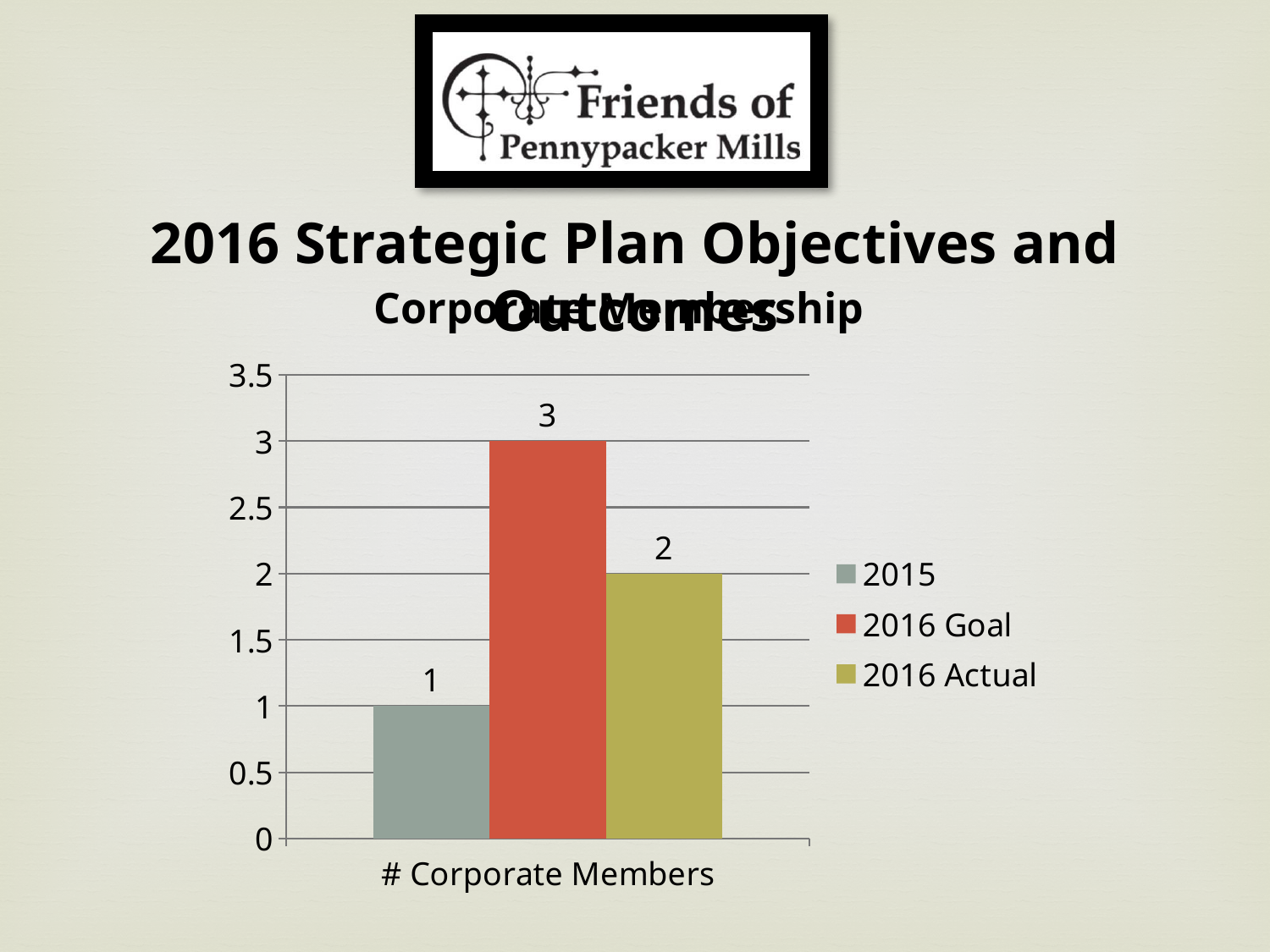
Is the value for 2016 Goal greater or less than 2.5? greater What is the category label shown on the x axis of the chart? # Corporate Members How many series does the legend list? 3 Which series has the lowest value for # Corporate Members? 2015 What kind of chart is shown on the slide? Bar chart What is the value for 2016 Goal in the # Corporate Members chart? 3 Which is larger for # Corporate Members, the 2016 Actual value or the 2015 value? 2016 Actual Which series has the highest value for # Corporate Members? 2016 Goal What is the difference between the 2016 Goal and the 2016 Actual values for # Corporate Members? 1 What is the value for 2015 in the # Corporate Members chart? 1 What is the difference between the 2016 Actual and the 2015 values for # Corporate Members? 1 What is the value for 2016 Actual in the # Corporate Members chart? 2